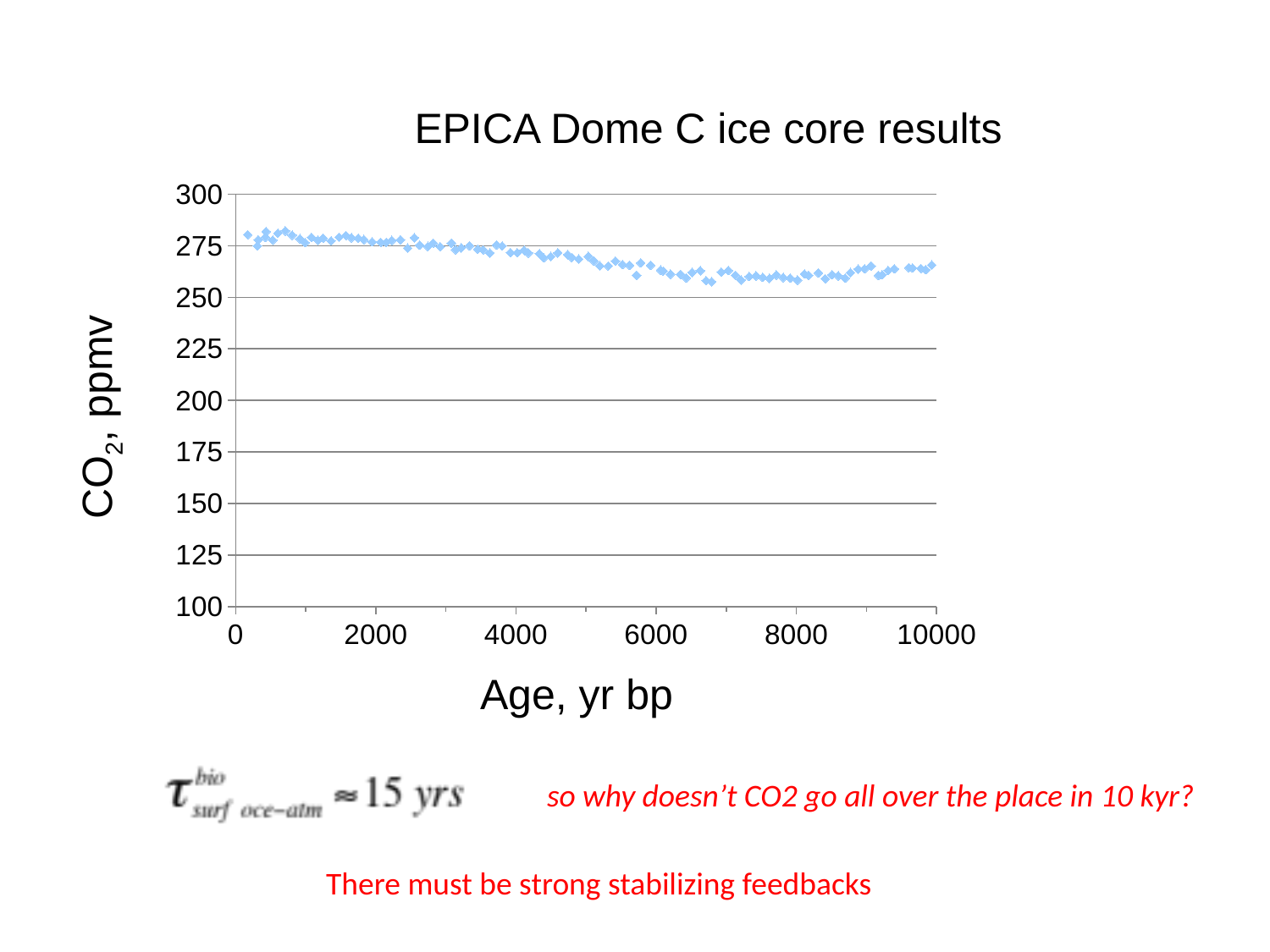
Do the CO2 values generally rise or fall as age increases from 0 to 10000 yr bp? fall What is the title of the chart? EPICA Dome C ice core results Is the CO2 value higher at about 500 yr bp or at about 6500 yr bp? 500 yr bp Are all the plotted CO2 values greater or less than 225? greater What is the label of the vertical axis of the chart? CO2, ppmv What kind of chart is shown on the slide? scatter chart Is the CO2 value at about 8000 yr bp greater or less than 275? less Is the CO2 value at about 7000 yr bp greater or less than 275? less Is the CO2 value higher at about 1000 yr bp or at about 8000 yr bp? 1000 yr bp